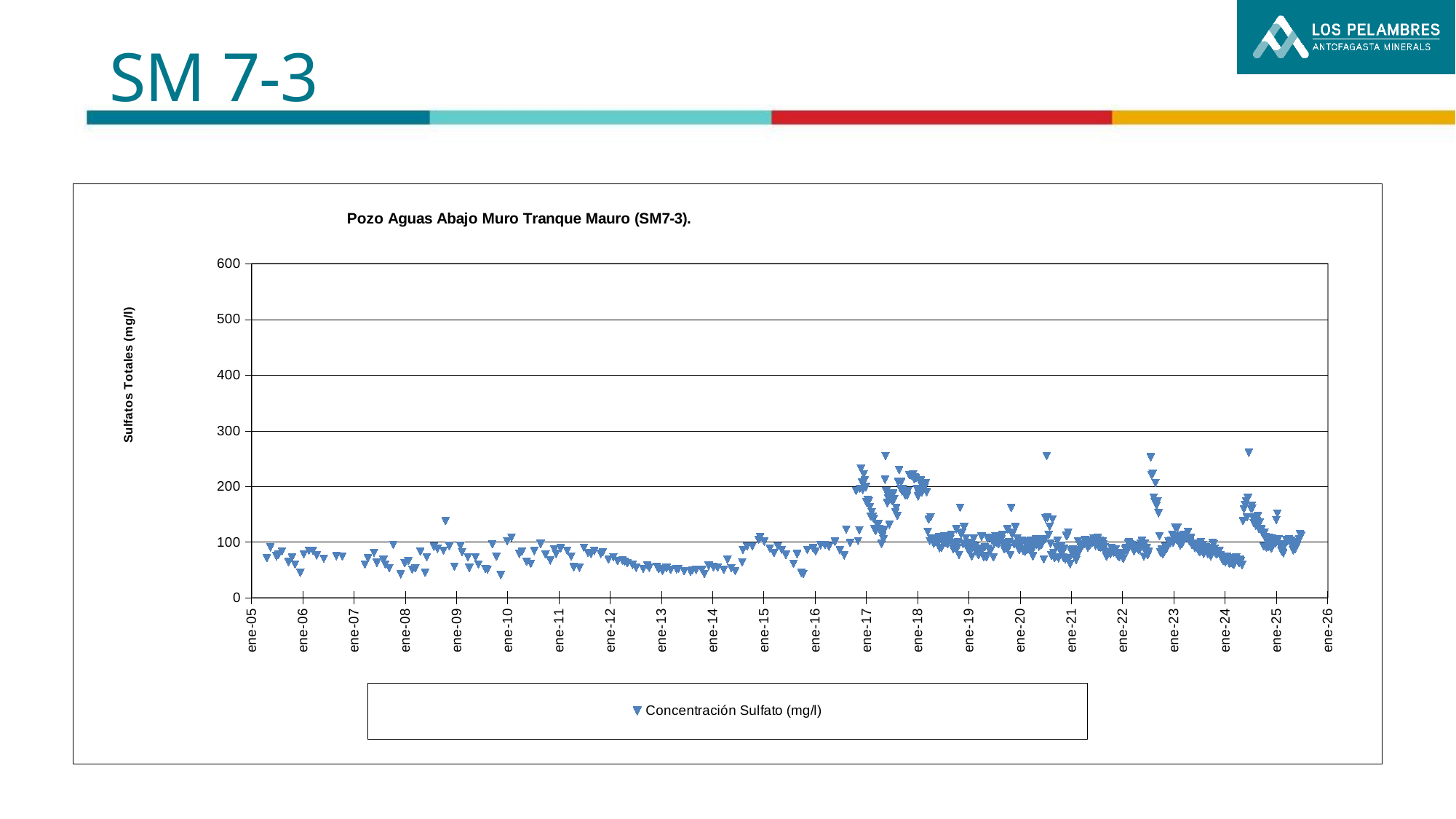
How many labelled tick marks are on the x axis? 22 Do the values rise or fall between ene-12 and ene-14? fall Are the values plotted between ene-17 and ene-18 mostly greater or less than 100? greater How many series does the legend list? 1 Is the highest plotted sulfate value greater or less than 200? greater Do the values rise or fall between ene-15 and ene-17? rise Are the values plotted around ene-13 greater or less than 100? less What is the title of the chart? Pozo Aguas Abajo Muro Tranque Mauro (SM7-3). What entry does the chart legend list? Concentración Sulfato (mg/l) Which period shows higher sulfate values, around ene-13 or around ene-17? ene-17 What kind of chart is shown on the slide? scatter chart